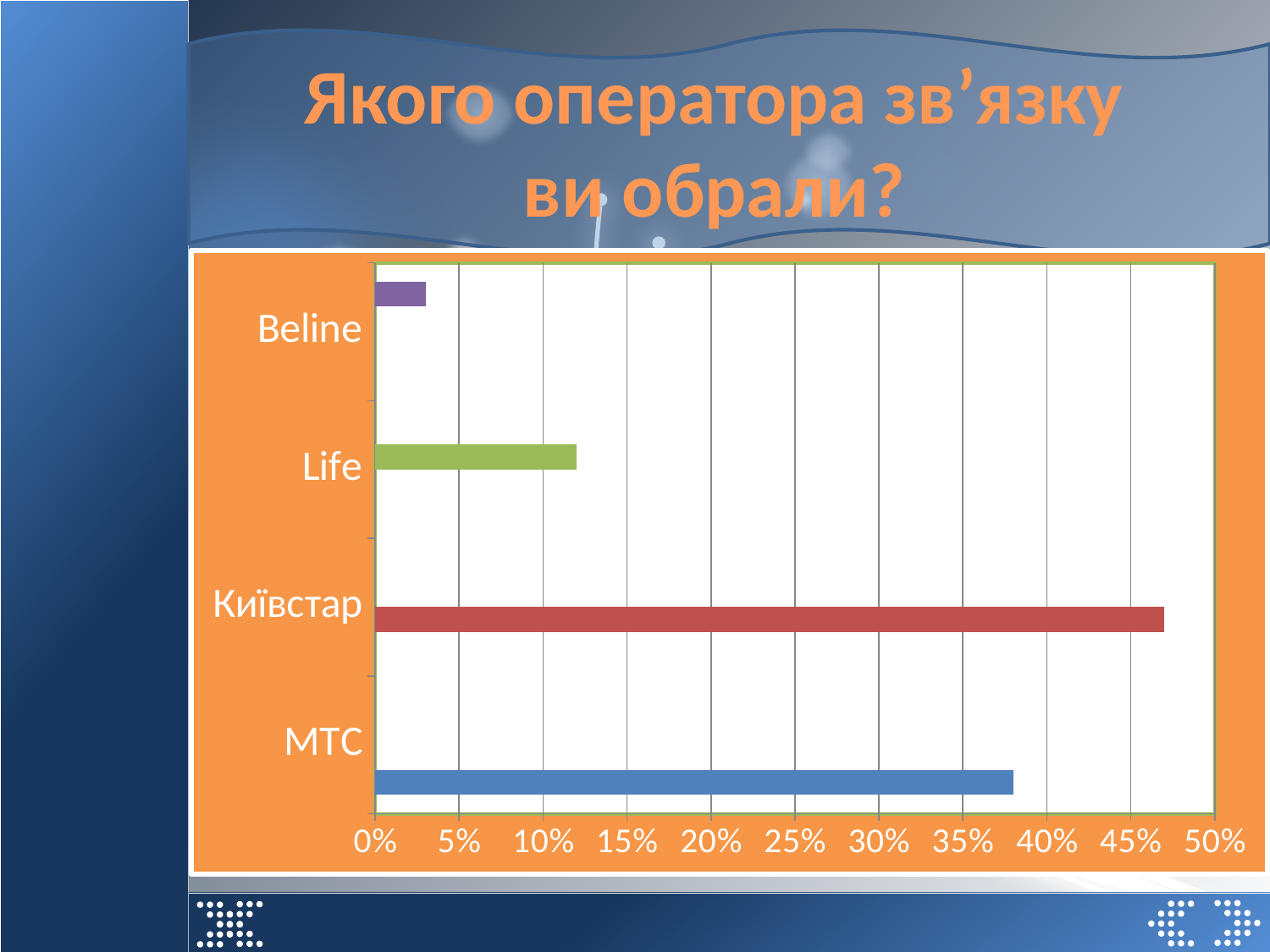
Which has a larger value, Life or МТС? МТС Is the value for Київстар greater or less than 45%? greater Which has a larger value, Київстар or МТС? Київстар Is the value for Life greater or less than 10%? greater Is the value for МТС greater or less than 40%? less What is the maximum value shown on the horizontal axis of the chart? 50% Which operator has the highest value in the chart? Київстар What is the title of the slide containing the chart? Якого оператора зв’язку ви обрали? How many operators (categories) are shown in the chart? 4 Which operator has the lowest value in the chart? Beline What kind of chart is shown on the slide? bar chart